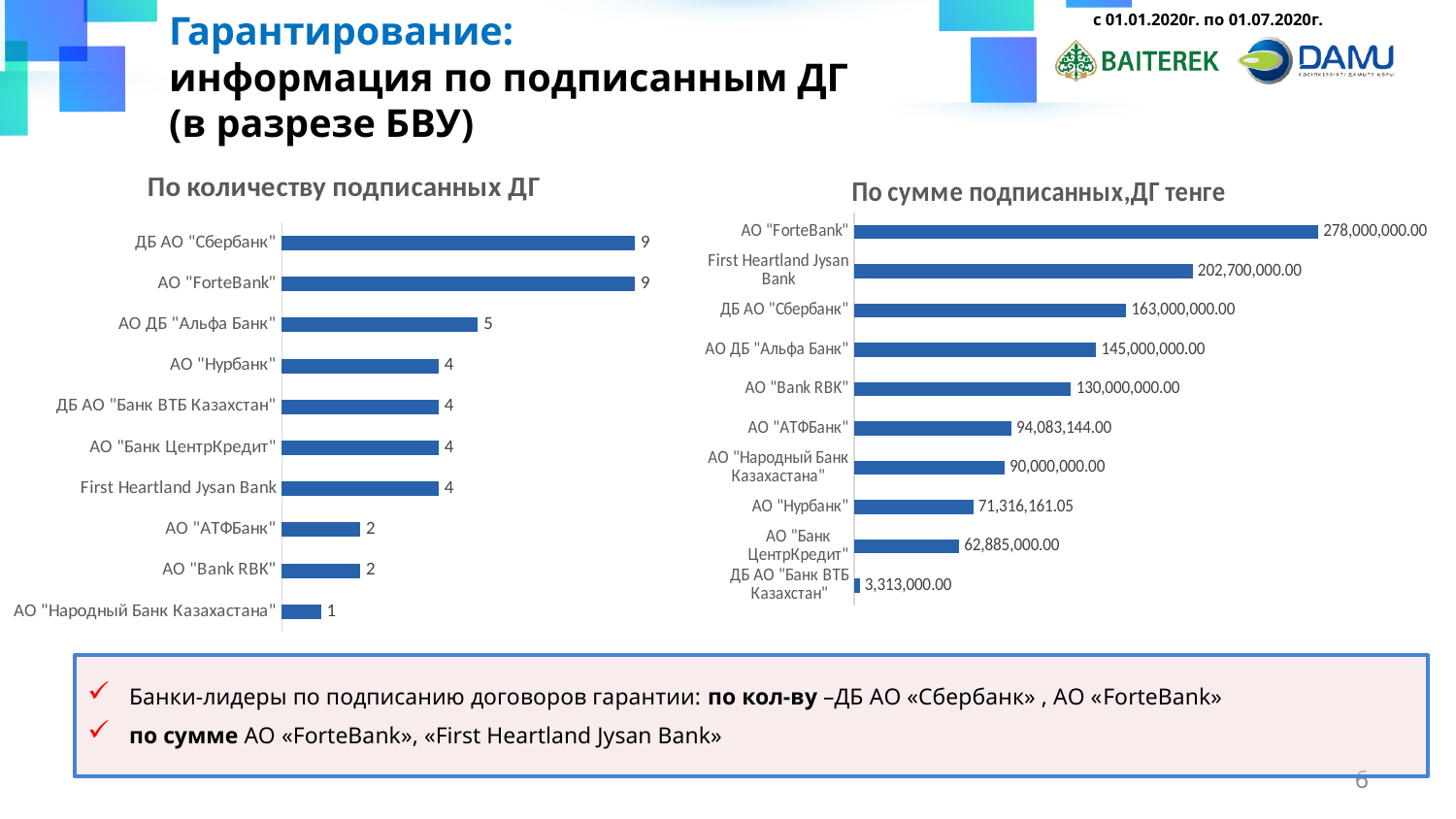
In the chart "По сумме подписанных,ДГ тенге", what is the value for АО "Нурбанк"? 71,316,161.05 In the chart "По сумме подписанных,ДГ тенге", which bank has the lowest value? ДБ АО "Банк ВТБ Казахстан" In the chart "По сумме подписанных,ДГ тенге", what is the value for First Heartland Jysan Bank? 202,700,000.00 In the chart "По сумме подписанных,ДГ тенге", what is the difference between the values for АО "ForteBank" and ДБ АО "Сбербанк"? 115,000,000.00 In the chart "По количеству подписанных ДГ", how many banks are shown? 10 In the chart "По количеству подписанных ДГ", what is the value for АО "Bank RBK"? 2 What type of chart is "По сумме подписанных,ДГ тенге"? Bar chart In the chart "По сумме подписанных,ДГ тенге", which is larger: the value for АО "Bank RBK" or the value for АО "АТФБанк"? АО "Bank RBK" In the chart "По количеству подписанных ДГ", what is the difference between the values for ДБ АО "Сбербанк" and АО "АТФБанк"? 7 In the chart "По сумме подписанных,ДГ тенге", which bank has the highest value? АО "ForteBank" In the chart "По количеству подписанных ДГ", which bank has the lowest value? АО "Народный Банк Казахстана" In the chart "По количеству подписанных ДГ", what is the value for АО ДБ "Альфа Банк"? 5